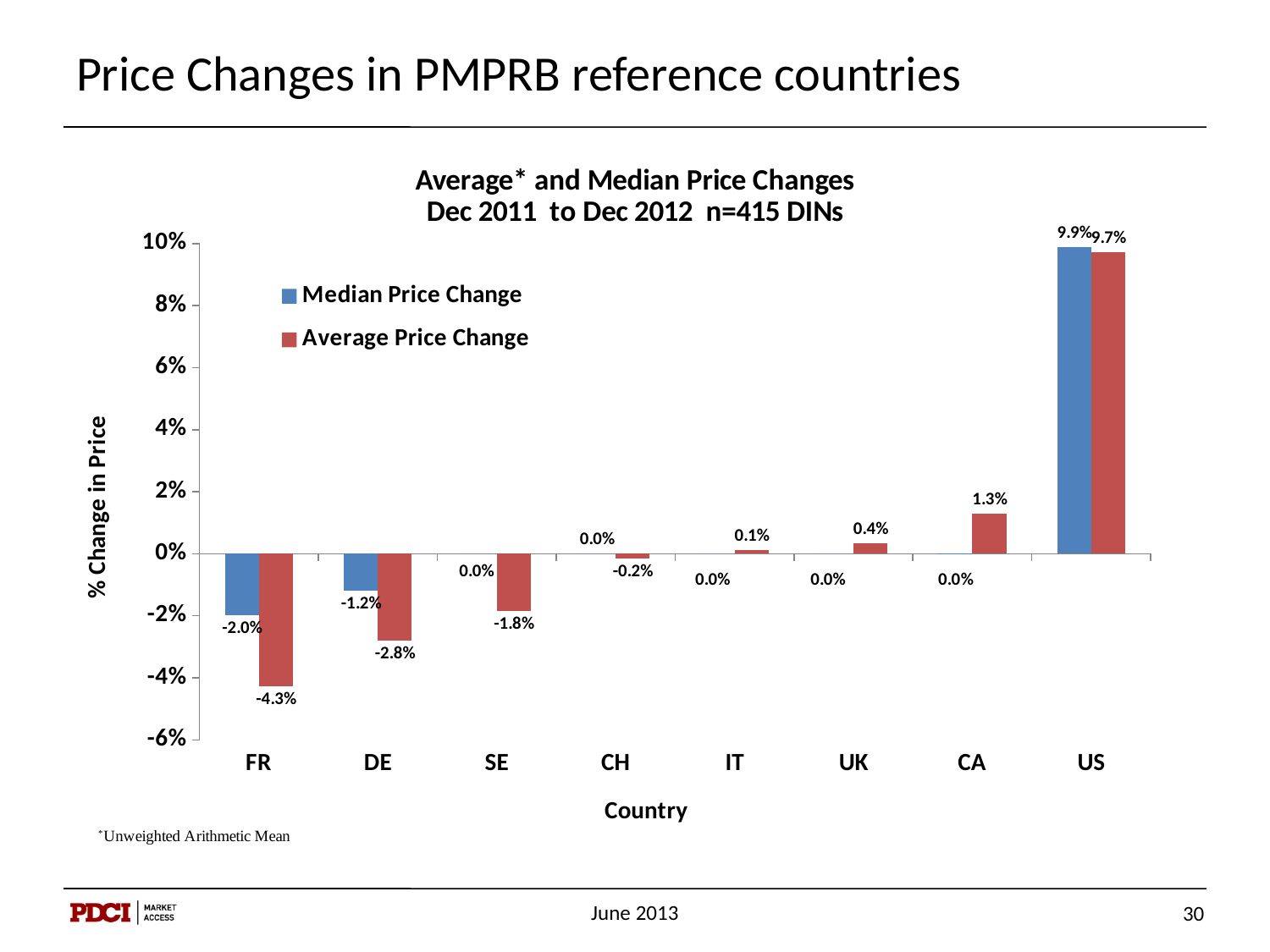
Which country has the lowest Average Price Change? FR Is the Average Price Change for US greater or less than 8%? greater Which country has the highest Average Price Change? US How many series does the legend list? 2 What is the difference between the Average Price Change for FR and for DE? 1.5% What is the Average Price Change for CA? 1.3% What is the Average Price Change for FR? -4.3% What is the Median Price Change for US? 9.9% Which is larger for US, the Median Price Change or the Average Price Change? Median Price Change How many countries are shown on the x axis? 8 What kind of chart is shown on the slide? Bar chart What is the Median Price Change for DE? -1.2%